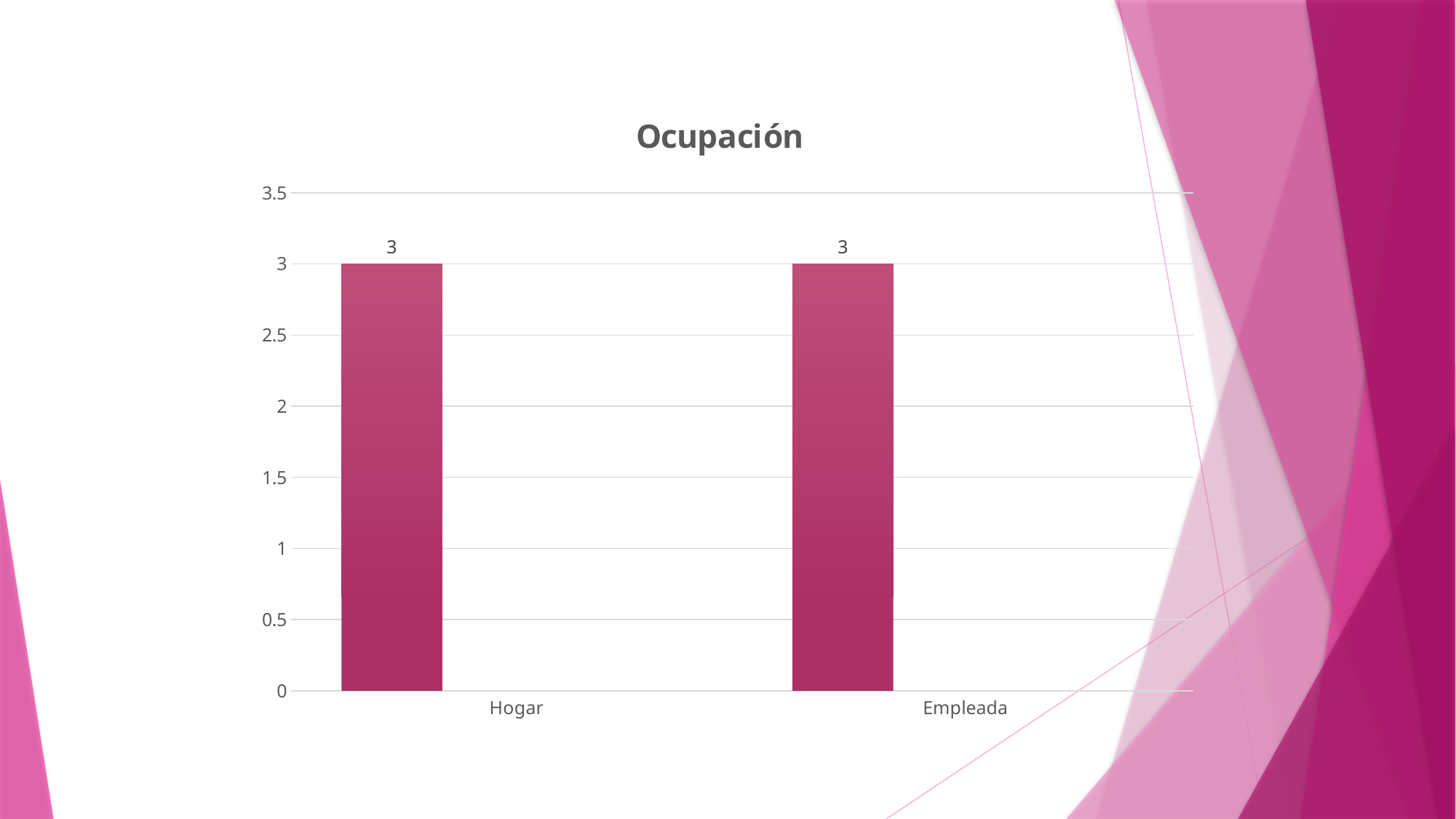
What is the value for Empleada? 3 What is the difference between the values for Hogar and Empleada? 0 What kind of chart is shown on the slide? bar chart What is the title of the chart? Ocupación What is the value for Hogar? 3 Do the values for Hogar and Empleada differ? No, both are 3 Is the value for Hogar greater or less than 2? greater What is the highest value shown on the y axis? 3.5 Is the value for Empleada greater or less than 3.5? less How many categories are shown on the x axis? 2